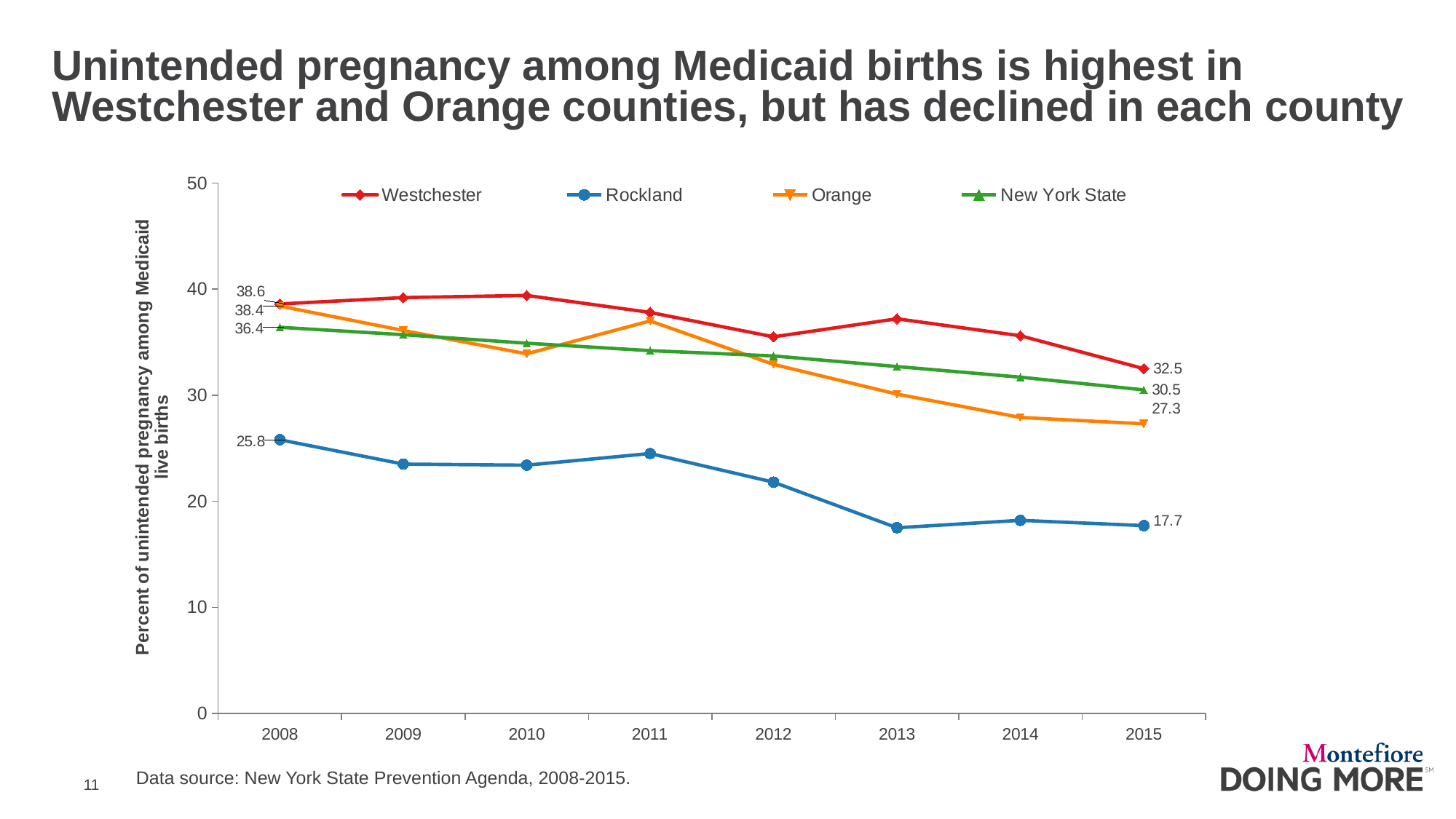
How many years are shown on the x axis? 8 What was the value for New York State in 2008? 36.4 By how much did the Westchester value fall from 2008 to 2015? 6.1 What was the value for Rockland in 2015? 17.7 Which series had the lowest value in 2015? Rockland What kind of chart is shown on the slide? Line chart What was the value for Orange in 2015? 27.3 Which series had the highest value in 2015? Westchester What was the percent of unintended pregnancy among Medicaid live births for Westchester in 2008? 38.6 How many series does the legend list? 4 Which was larger in 2015, the value for New York State or the value for Orange? New York State Is the value for Rockland in 2013 greater or less than 20? less